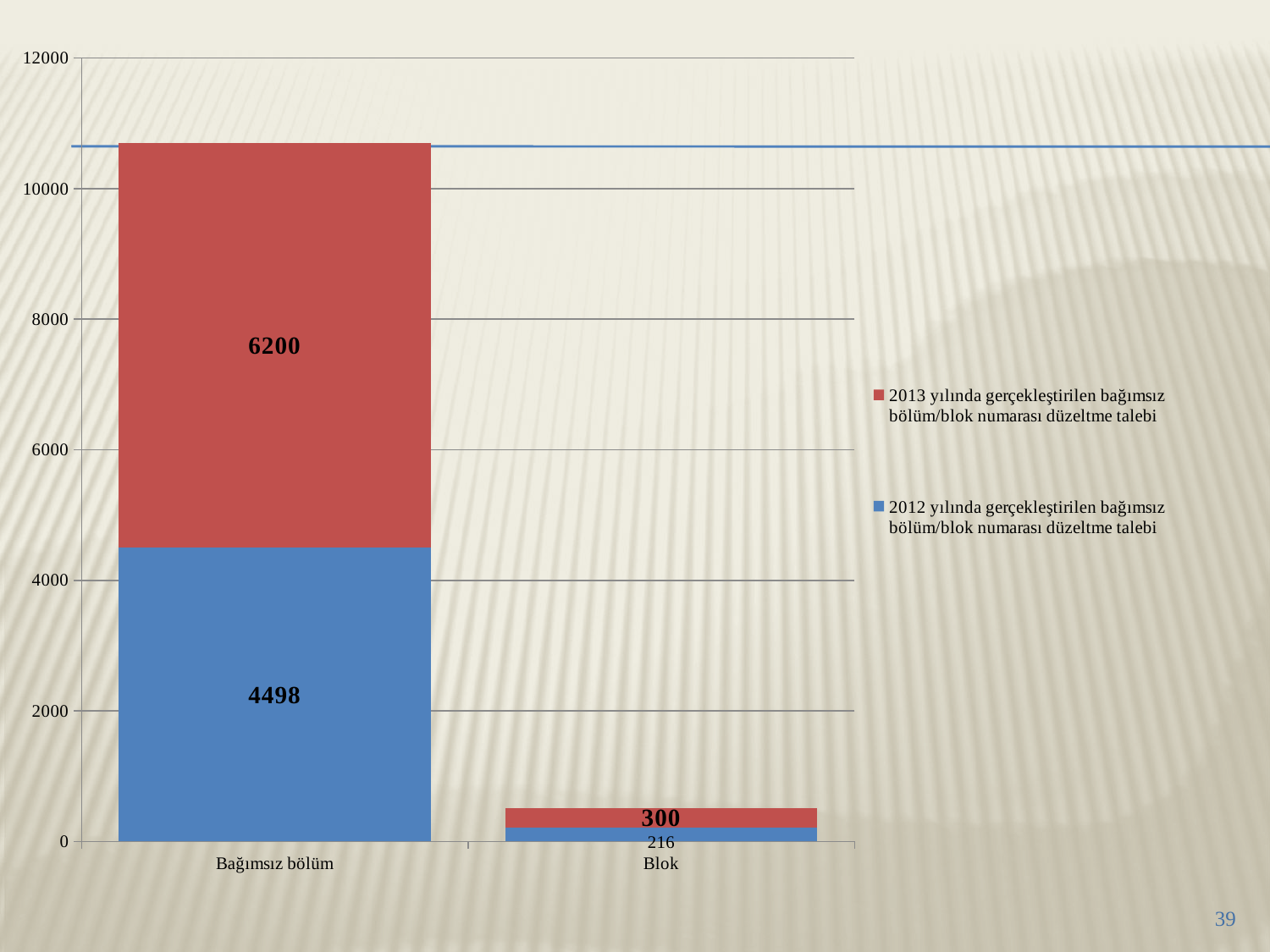
What is the 2013 value for Blok? 300 Which category has the higher total, Bağımsız bölüm or Blok? Bağımsız bölüm What is the 2013 value for Bağımsız bölüm? 6200 What is the total of the stacked bar for Bağımsız bölüm? 10698 What kind of chart is shown on the slide? Stacked bar chart Is the total for Bağımsız bölüm greater or less than 10000? greater What is the 2012 value for Blok? 216 What is the total of the stacked bar for Blok? 516 How many series does the legend list? 2 What is the 2012 value for Bağımsız bölüm? 4498 How many categories are shown on the x axis? 2 What is the difference between the 2013 and 2012 values for Bağımsız bölüm? 1702